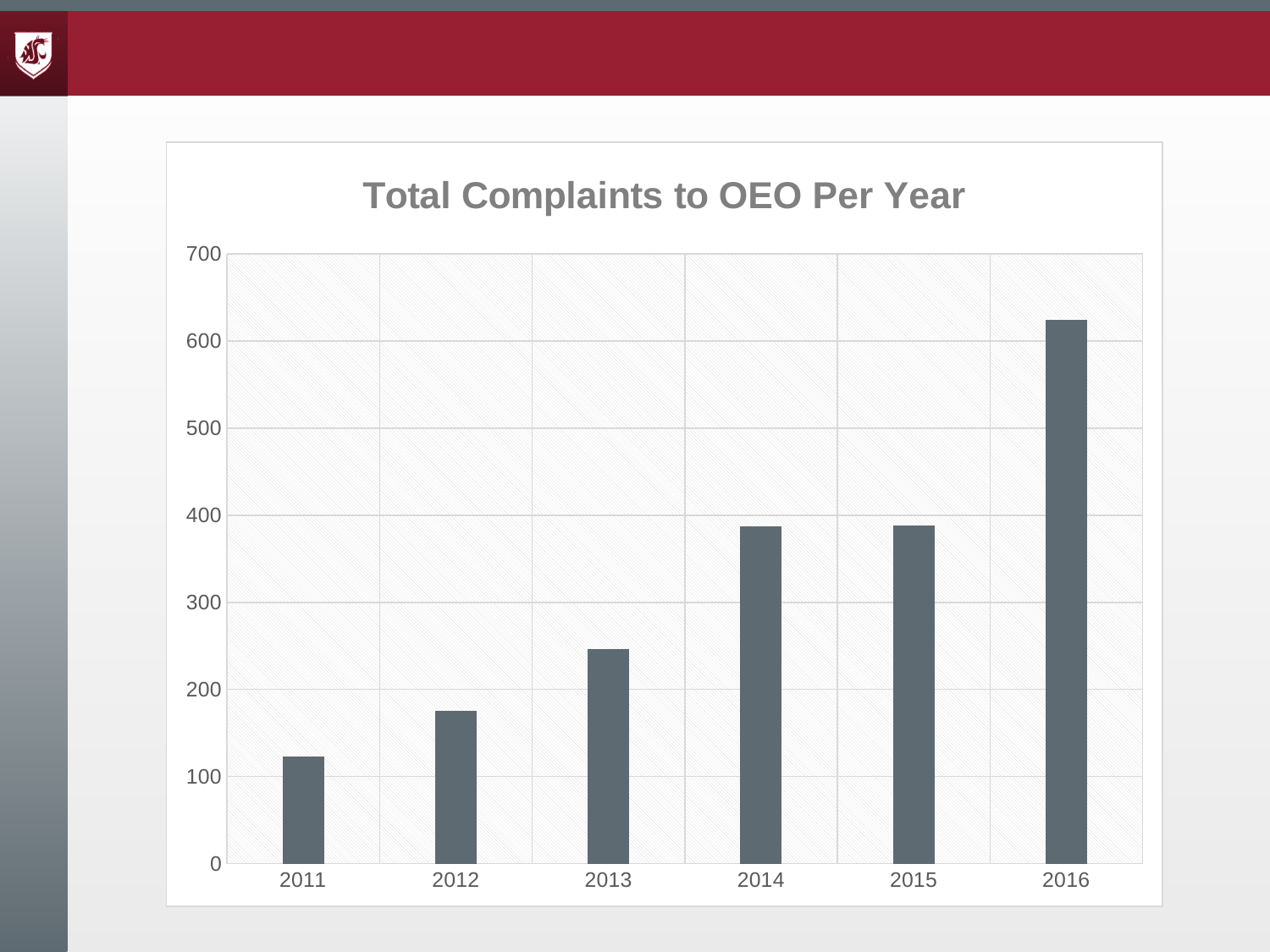
Is the value for 2011 greater or less than 200? less Which year has the highest number of complaints? 2016 What is the title of the chart? Total Complaints to OEO Per Year Which is larger, the value for 2013 or the value for 2015? 2015 Is the value for 2014 greater or less than 400? less Is the value for 2012 greater or less than 100? greater How many years are shown on the x axis of the chart? 6 What type of chart is shown on the slide? bar chart Which year has the lowest number of complaints? 2011 Do the values generally rise or fall from 2011 to 2016? rise